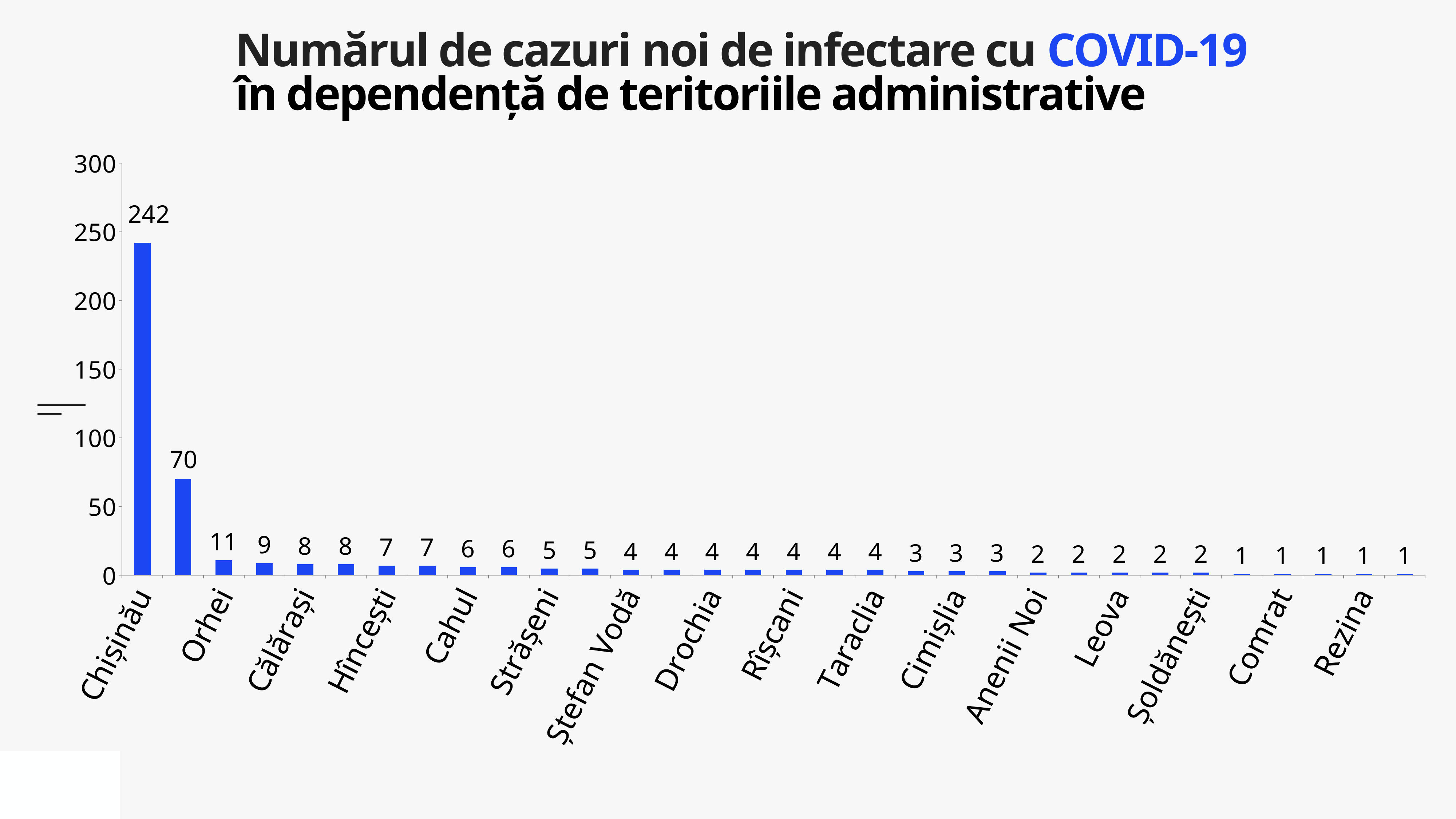
Which is larger, the value for Chișinău or the value for Orhei? Chișinău How many bars have a value of 1? 5 What is the difference between the highest value (242) and the second-highest value (70)? 172 What kind of chart is shown? bar chart Is the value for Chișinău greater or less than 200? greater What is the highest value shown on the chart? 242 What is the second-highest value shown on the chart? 70 Which territory has the highest number of new cases? Chișinău What is the value for Chișinău? 242 How many bars are plotted on the chart? 32 What is the lowest value shown on the chart? 1 Do the values rise or fall from left to right along the x axis? fall